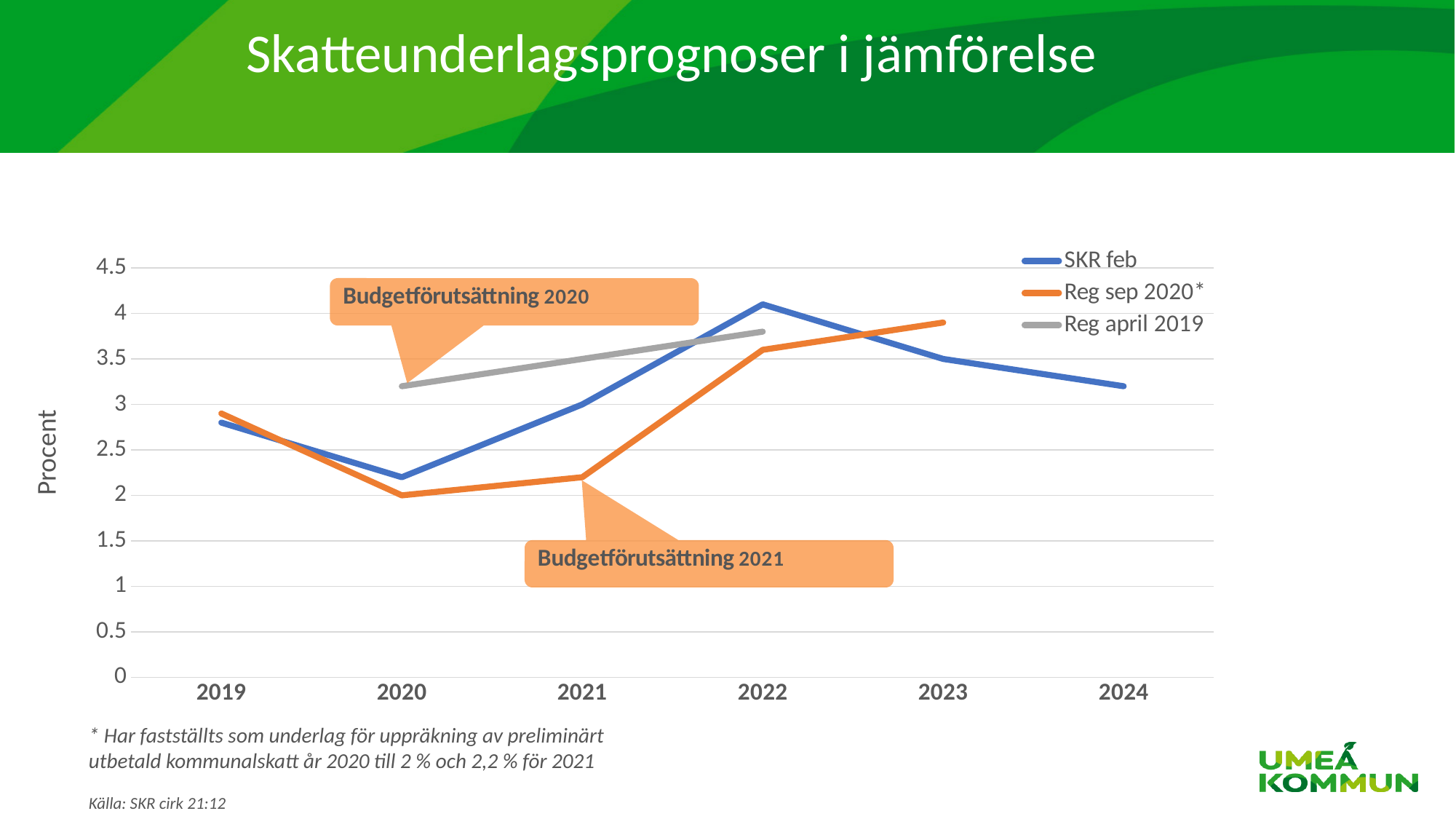
In which year does the SKR feb series have its lowest value? 2020 Is the value for Reg april 2019 in 2020 greater or less than 3? greater What kind of chart is shown on the slide? line chart What is the label on the y axis? Procent How many series does the legend list? 3 Does the Reg april 2019 series rise or fall from 2020 to 2022? rise Is the value for SKR feb in 2022 greater or less than 4? greater How many years are shown on the x axis? 6 In which year does the SKR feb series reach its highest value? 2022 What is the value of Reg sep 2020* in 2020? 2 In 2022, which series has the larger value, SKR feb or Reg sep 2020*? SKR feb What is the value of SKR feb in 2021? 3